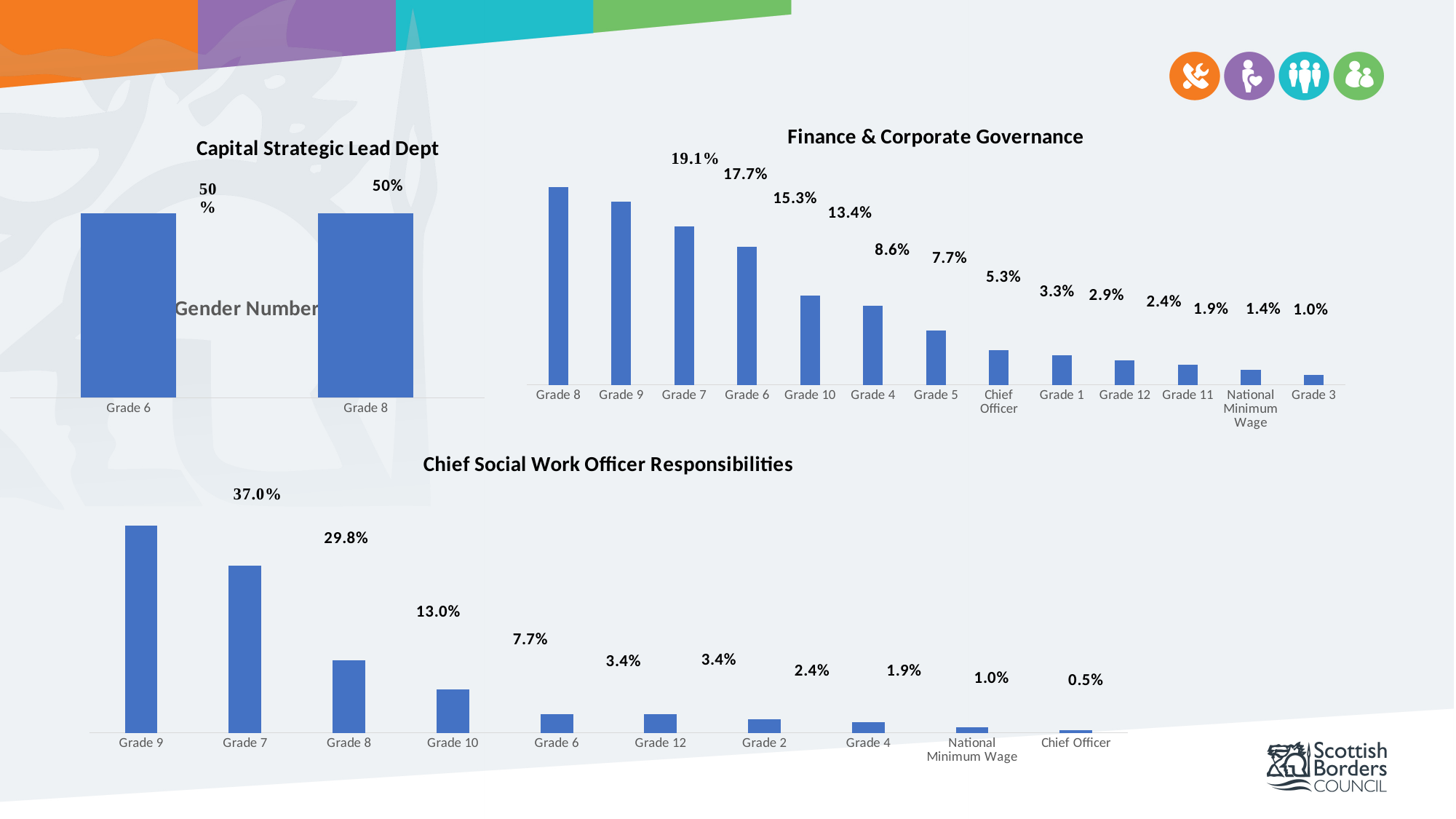
In the Chief Social Work Officer Responsibilities chart, what is the value for Grade 9? 37.0% In the Chief Social Work Officer Responsibilities chart, what is the value for National Minimum Wage? 1.0% In the Chief Social Work Officer Responsibilities chart, which category has the highest value? Grade 9 In the Finance & Corporate Governance chart, what is the value for Grade 8? 19.1% In the Chief Social Work Officer Responsibilities chart, how many categories are shown on the x axis? 10 In the Finance & Corporate Governance chart, what is the difference between the values for Grade 9 and Grade 7? 2.4% In the Chief Social Work Officer Responsibilities chart, which is larger, the value for Grade 8 or the value for Grade 10? Grade 8 What kind of chart is the Capital Strategic Lead Dept chart? Bar chart In the Finance & Corporate Governance chart, which category has the lowest value? Grade 3 In the Finance & Corporate Governance chart, how many categories are shown on the x axis? 13 In the Finance & Corporate Governance chart, what is the value for Chief Officer? 5.3% In the Capital Strategic Lead Dept chart, what is the value for Grade 8? 50%